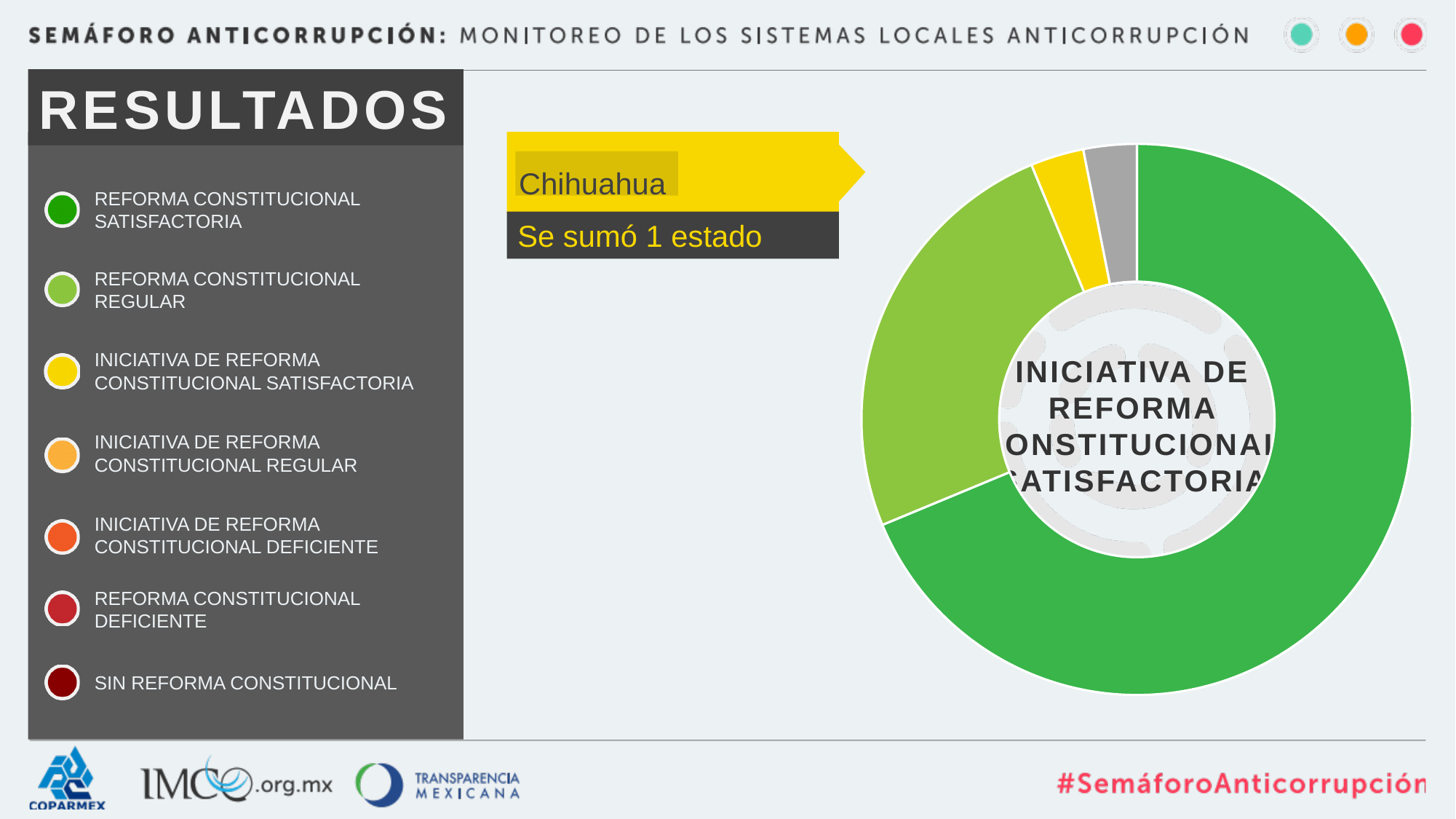
Which state is named in the yellow callout next to the chart? Chihuahua Does the dark green slice (Reforma constitucional satisfactoria) take up more or less than half of the pie? more Which slice is larger: Reforma constitucional satisfactoria (dark green) or Reforma constitucional regular (light green)? Reforma constitucional satisfactoria How many categories are listed in the legend on the left of the slide? 7 What kind of chart is shown on the slide? doughnut chart How many slices does the pie chart have? 4 Which slice is larger: Reforma constitucional regular (light green) or Iniciativa de reforma constitucional satisfactoria (yellow)? Reforma constitucional regular Which category has the largest slice in the pie chart? Reforma constitucional satisfactoria What text is written in the centre of the pie chart? Iniciativa de reforma constitucional satisfactoria